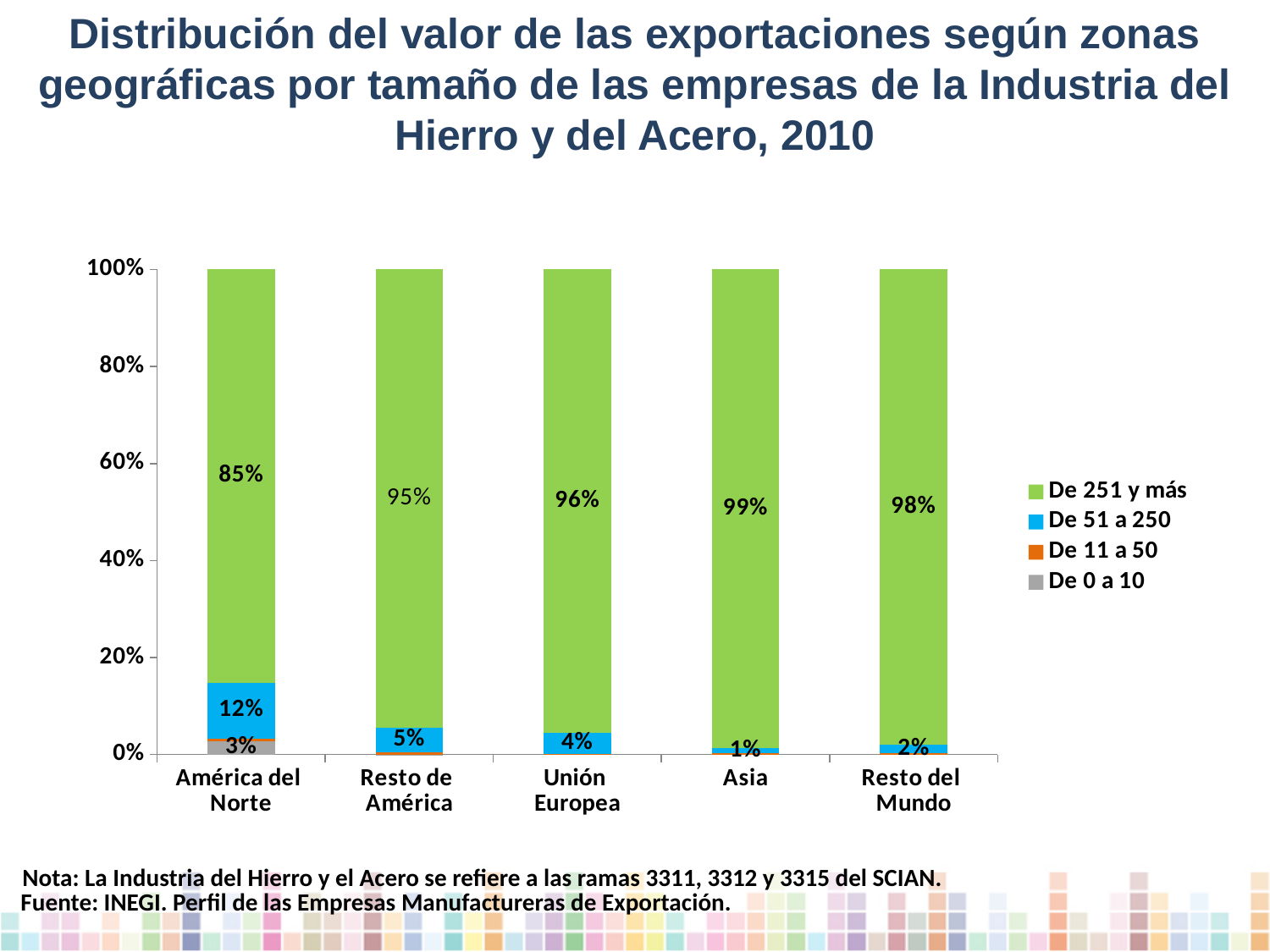
What is the value for 'De 251 y más' in Asia? 99% What is the difference between the 'De 251 y más' values for Resto de América and América del Norte? 10% What is the value for 'De 51 a 250' in Unión Europea? 4% What kind of chart is shown on the slide? Stacked bar chart What is the value for 'De 251 y más' in Resto del Mundo? 98% How many geographic zones are shown on the x axis? 5 How many series does the legend list? 4 What is the value for 'De 51 a 250' in América del Norte? 12% What is the value for 'De 251 y más' in América del Norte? 85% Which is larger, the 'De 51 a 250' value for Resto de América or for Resto del Mundo? Resto de América Which geographic zone has the highest value for 'De 251 y más'? Asia Which geographic zone has the lowest value for 'De 251 y más'? América del Norte